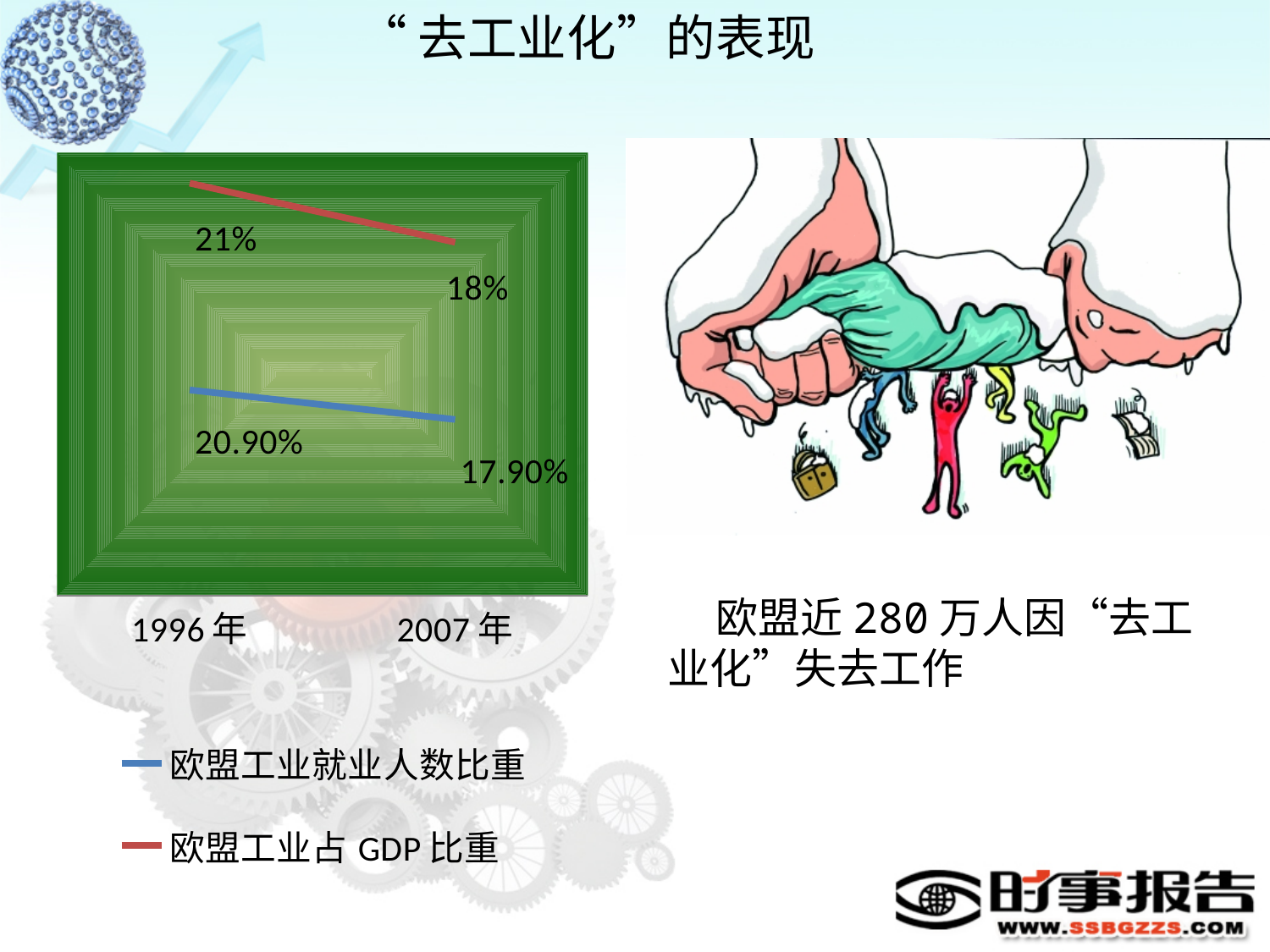
What is the value of 欧盟工业就业人数比重 in 1996年? 20.90% How many series does the legend list? 2 What is the value of 欧盟工业就业人数比重 in 2007年? 17.90% Does 欧盟工业占GDP比重 rise or fall from 1996年 to 2007年? fall By how many percentage points did 欧盟工业占GDP比重 change from 1996年 to 2007年? 3 percentage points Does 欧盟工业就业人数比重 rise or fall from 1996年 to 2007年? fall By how many percentage points did 欧盟工业就业人数比重 change from 1996年 to 2007年? 3 percentage points What is the value of 欧盟工业占GDP比重 in 1996年? 21% What kind of chart is shown on the left of the slide? line chart Which colour represents 欧盟工业就业人数比重 in the chart? blue How many years are shown on the x axis of the chart? 2 What is the value of 欧盟工业占GDP比重 in 2007年? 18%